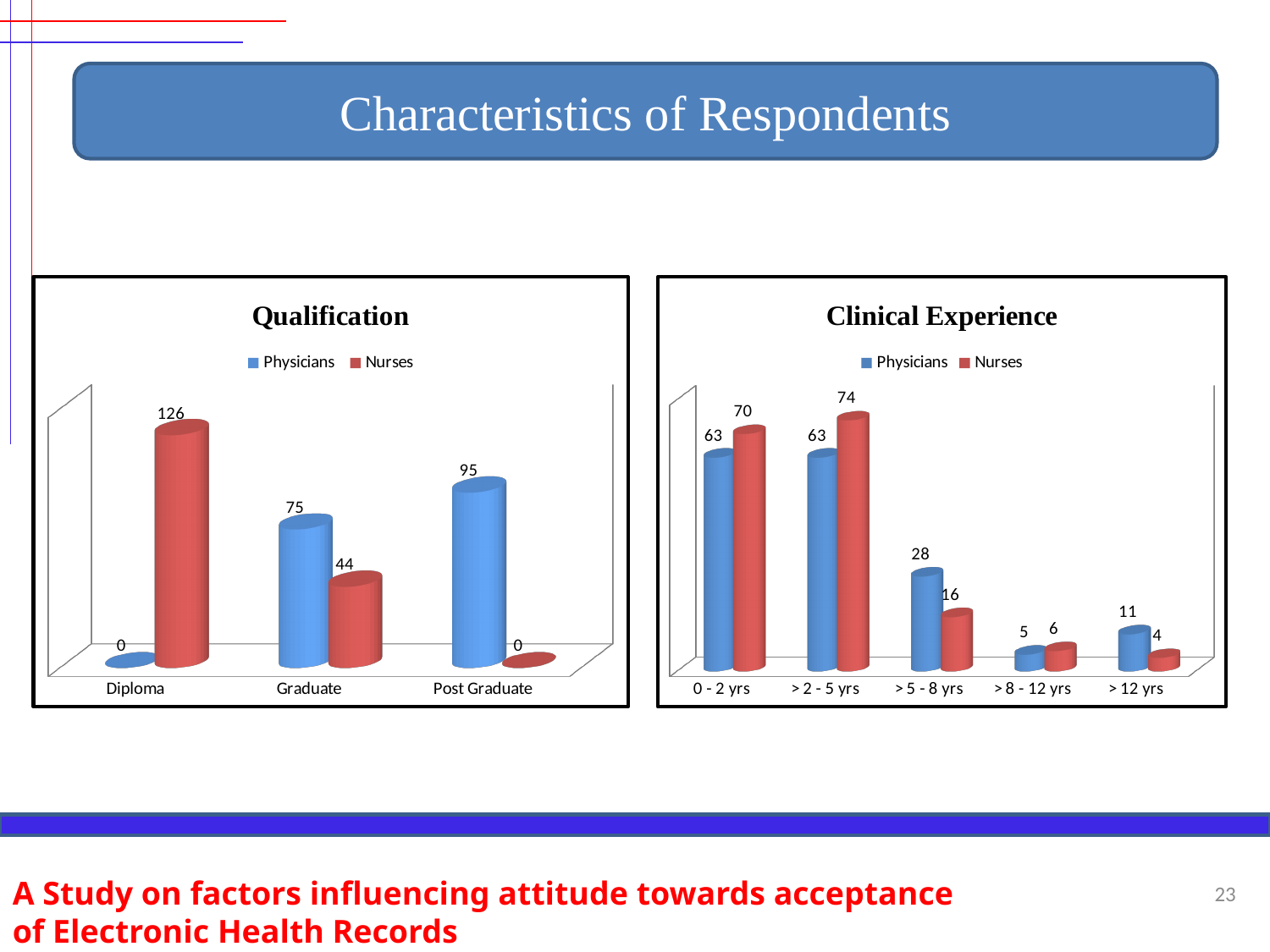
In the Qualification chart, which category has the highest value for Physicians? Post Graduate In the Clinical Experience chart, which category has the lowest value for Nurses? > 12 yrs In the Qualification chart, what is the value for Physicians in the Post Graduate category? 95 In the Qualification chart, how many categories are shown on the x axis? 3 In the Clinical Experience chart, how many series does the legend list? 2 What kind of chart is the Clinical Experience chart? Bar chart In the Clinical Experience chart, what is the value for Physicians in the > 5 - 8 yrs category? 28 In the Clinical Experience chart, what is the difference between Physicians and Nurses in the > 5 - 8 yrs category? 12 In the Clinical Experience chart, is the value for Physicians or Nurses larger in the > 12 yrs category? Physicians In the Clinical Experience chart, what is the value for Nurses in the > 2 - 5 yrs category? 74 In the Qualification chart, what is the value for Nurses in the Diploma category? 126 In the Qualification chart, what is the difference between Physicians and Nurses in the Graduate category? 31